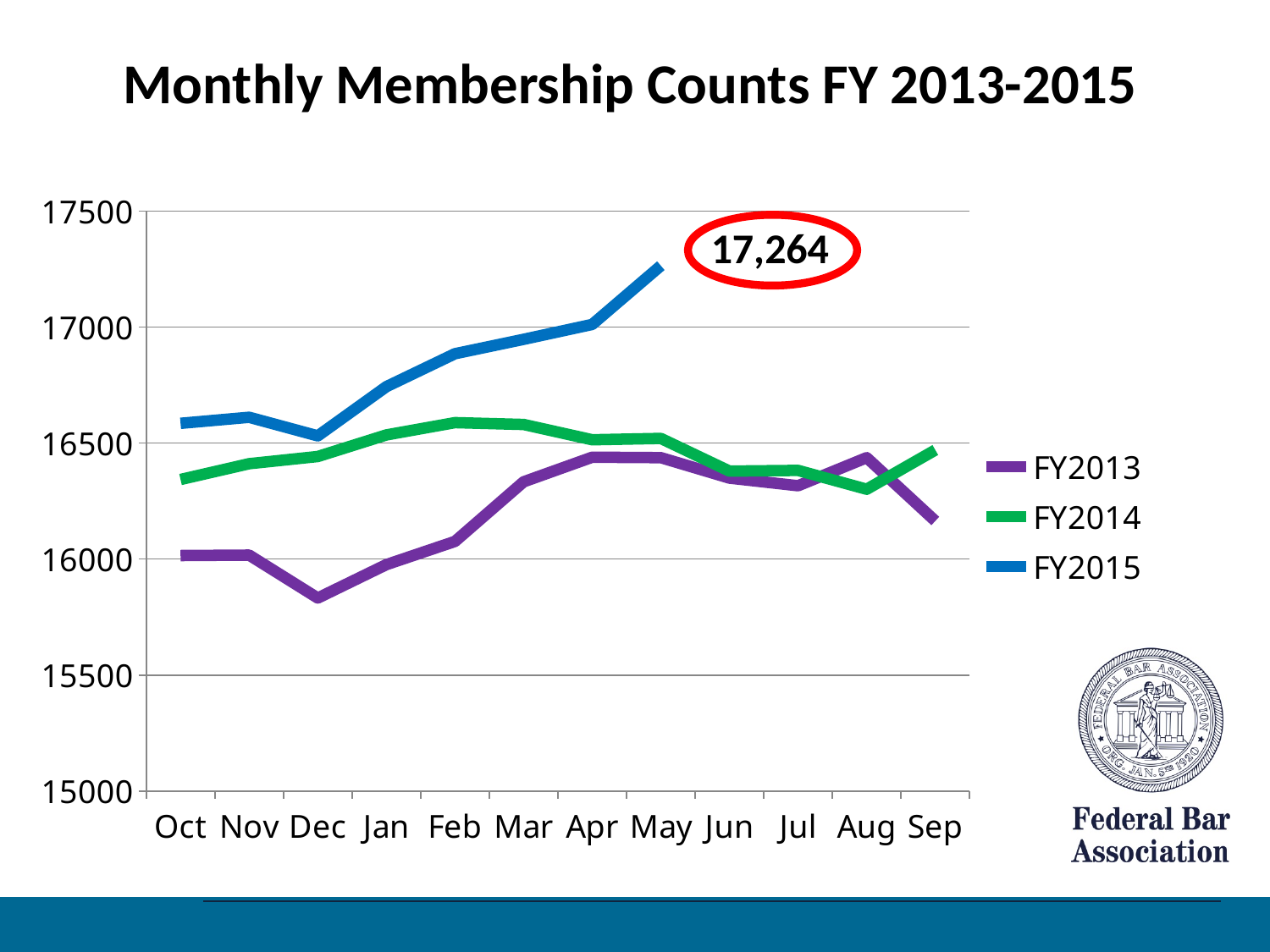
What kind of chart is shown on the slide? line chart Is the FY2015 value for Feb greater or less than 17000? less What is the title of the chart? Monthly Membership Counts FY 2013-2015 Is the FY2013 value for Dec greater or less than 16000? less In Oct, which series has the larger value, FY2013 or FY2015? FY2015 Which series has the highest value in Jan? FY2015 What is the FY2015 membership count for May? 17,264 Does the FY2015 series rise or fall from Dec to May? rise How many months are shown along the x axis? 12 In which month does the FY2013 series reach its lowest value? Dec How many series does the legend list? 3 Is the FY2014 value for Oct greater or less than 16500? less